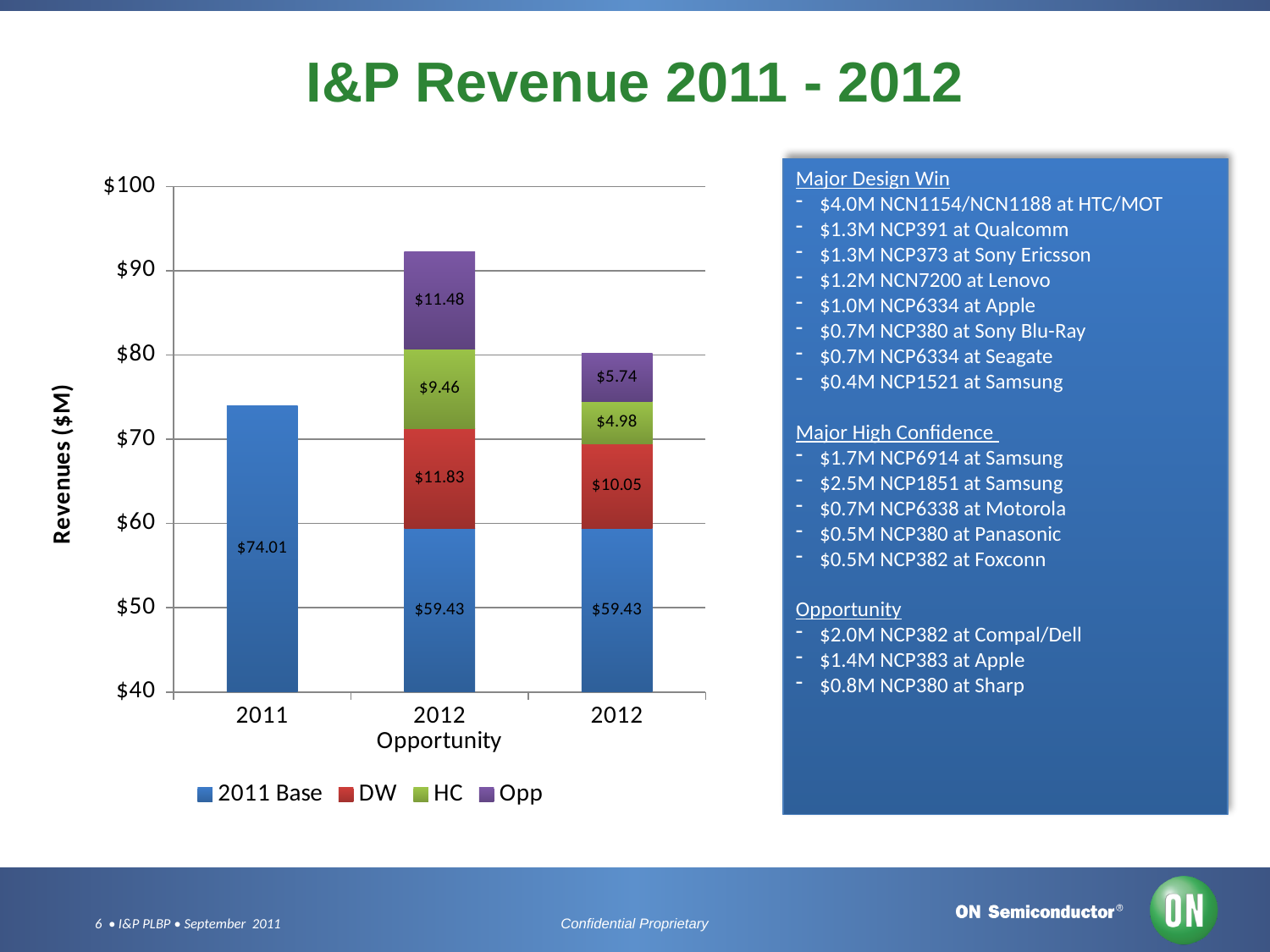
What is the Opp value for the 2012 bar? $5.74 What is the 2011 Base value for the 2011 bar? $74.01 What is the DW value for the 2012 Opportunity bar? $11.83 Which bar has the highest total? 2012 Opportunity Is the HC value larger for the 2012 Opportunity bar or the 2012 bar? 2012 Opportunity What is the total of the 2012 stacked bar? $80.20 What is the y-axis title of the chart? Revenues ($M) What kind of chart is shown on the slide? Stacked bar chart What is the HC value for the 2012 Opportunity bar? $9.46 How many series does the chart legend list? 4 What is the total of the 2012 Opportunity stacked bar? $92.20 What is the difference between the Opp values for the 2012 Opportunity bar and the 2012 bar? $5.74